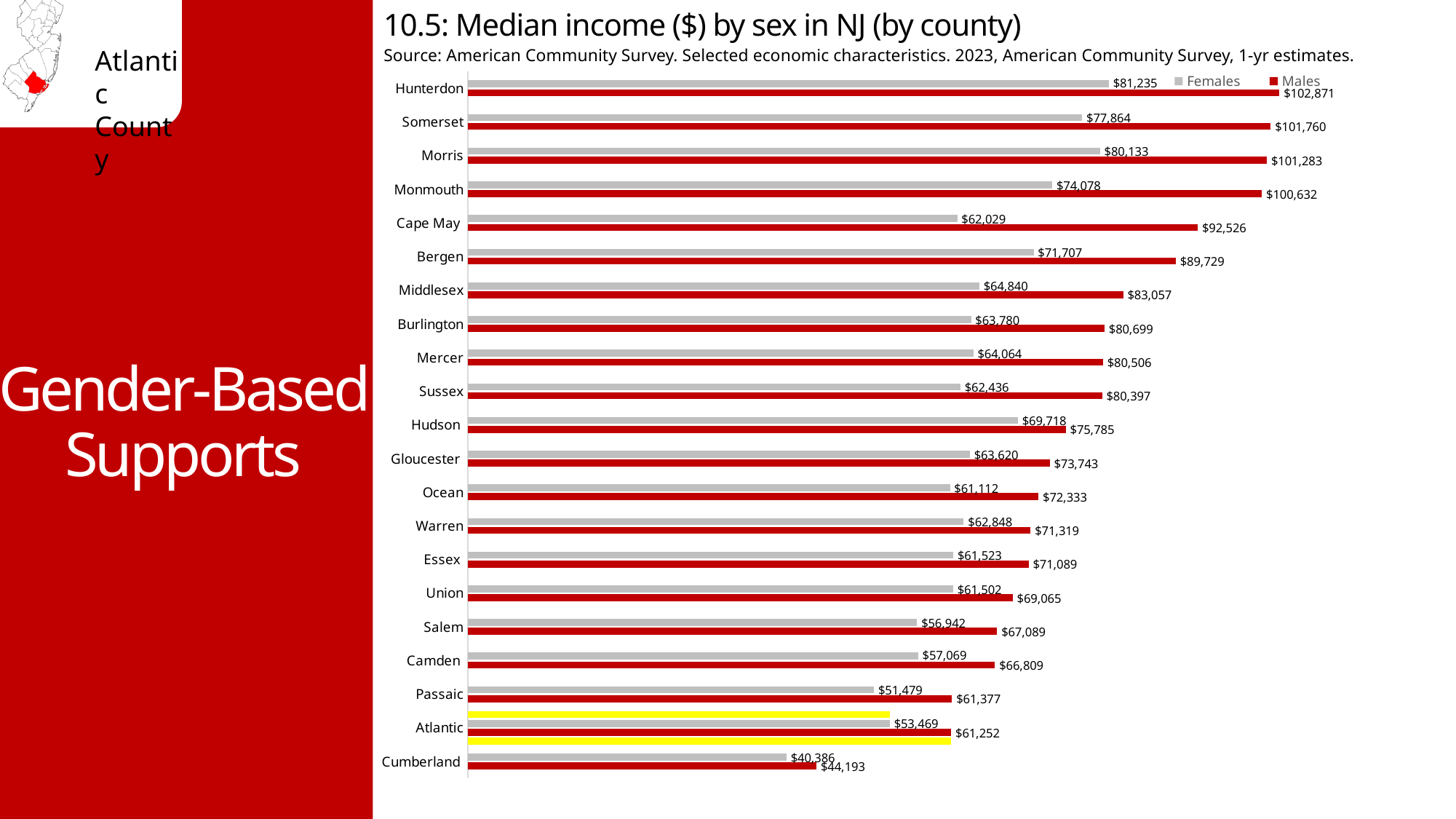
Which county has the highest median income for males? Hunterdon How many series does the legend list? 2 What is the median income for males in Atlantic County? $61,252 What is the median income for females in Hudson? $69,718 Which is larger, the female median income in Morris or in Somerset? Morris What is the median income for males in Cape May? $92,526 How many counties are shown in the chart? 21 What is the difference between male and female median income in Hunterdon? $21,636 What is the difference between male and female median income in Atlantic County? $7,783 Which county has the lowest median income for females? Cumberland What is the median income for females in Atlantic County? $53,469 What kind of chart is shown on the slide? Bar chart